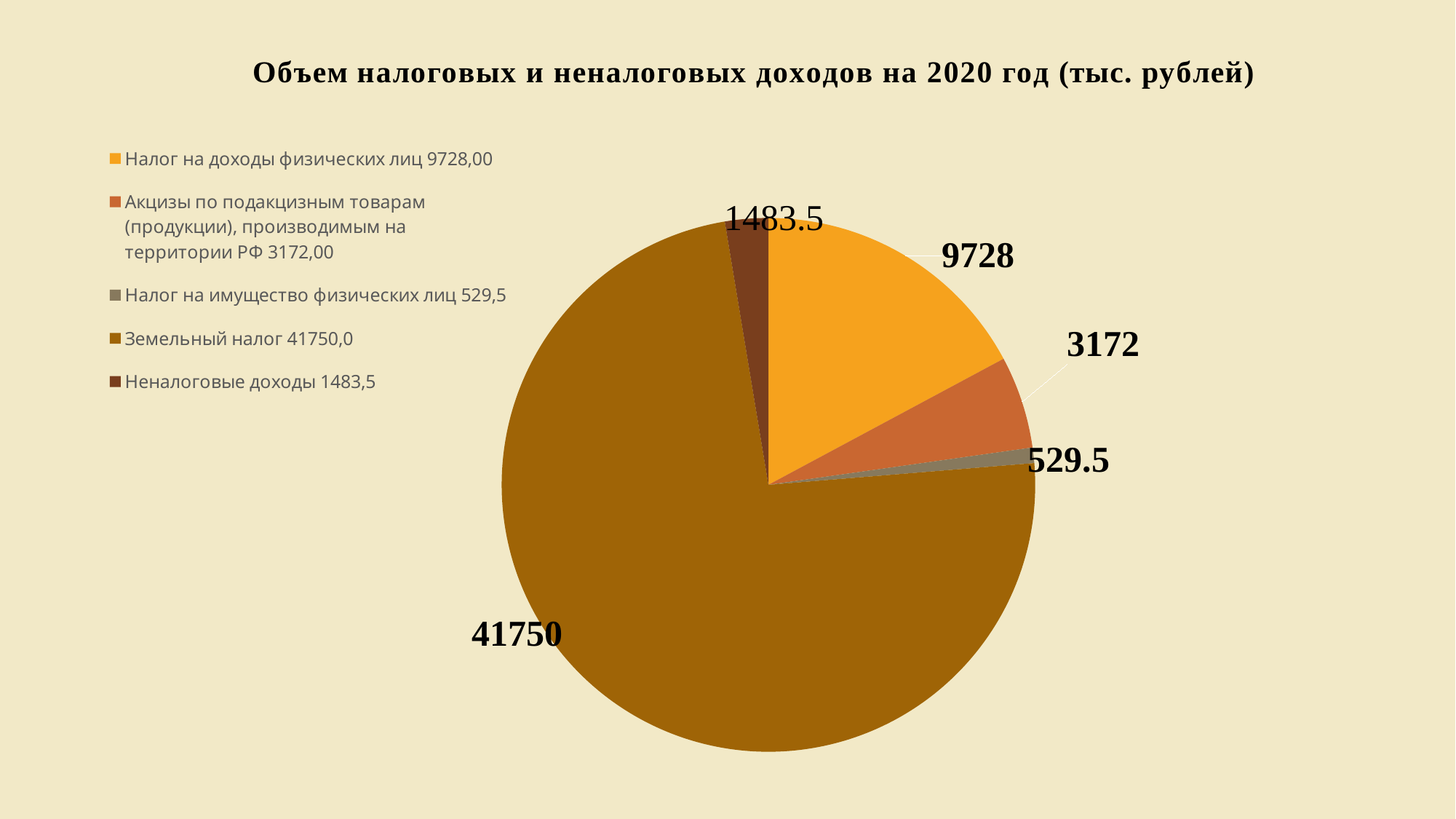
What is the value for Неналоговые доходы? 1483.5 What is the value for Земельный налог? 41750 Which category has the largest slice of the pie? Земельный налог What is the difference between the values for Неналоговые доходы and Налог на имущество физических лиц? 954 How many slices does the pie chart have? 5 Which is larger: the value for Акцизы по подакцизным товарам or the value for Неналоговые доходы? Акцизы по подакцизным товарам What is the difference between the values for Земельный налог and Налог на доходы физических лиц? 32022 Which category has the smallest slice of the pie? Налог на имущество физических лиц What is the value for Налог на имущество физических лиц? 529.5 What is the value for Налог на доходы физических лиц? 9728 What type of chart is shown on the slide? Pie chart What is the title of the chart? Объем налоговых и неналоговых доходов на 2020 год (тыс. рублей)